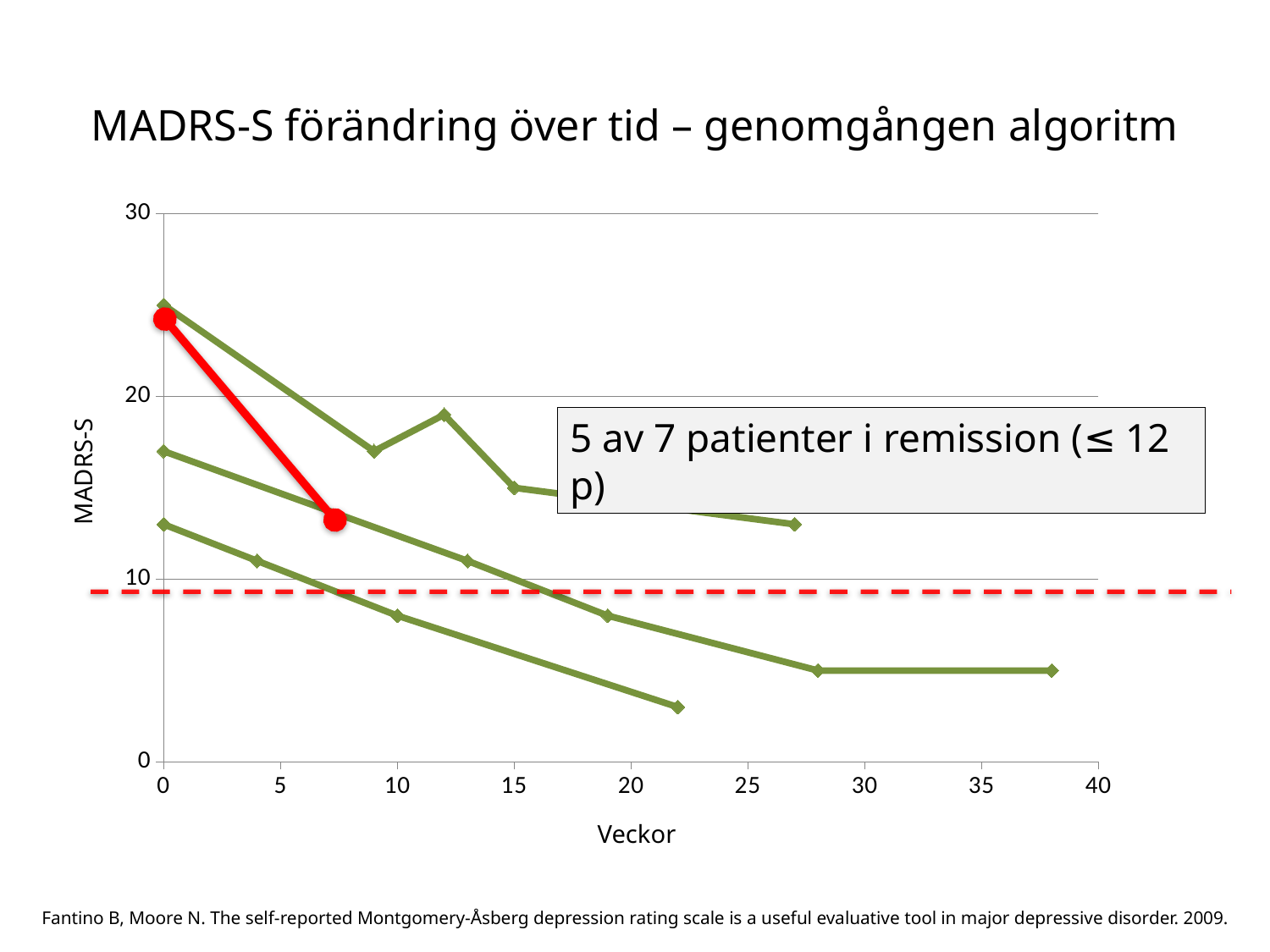
Is the value of the topmost green line at week 27 greater or less than 10? greater Is the starting value of the red line at week 0 greater or less than 20? greater What is the highest value shown on the y axis of the chart? 30 What kind of chart is shown on the slide? line chart What is the label on the x axis of the chart? Veckor Is the value of the lowest green line at week 22 greater or less than 10? less What is the title of the chart? MADRS-S förändring över tid – genomgången algoritm Which line starts higher at week 0: the red line or the lowest green line? the red line Do the MADRS-S values generally rise or fall as the weeks increase? fall